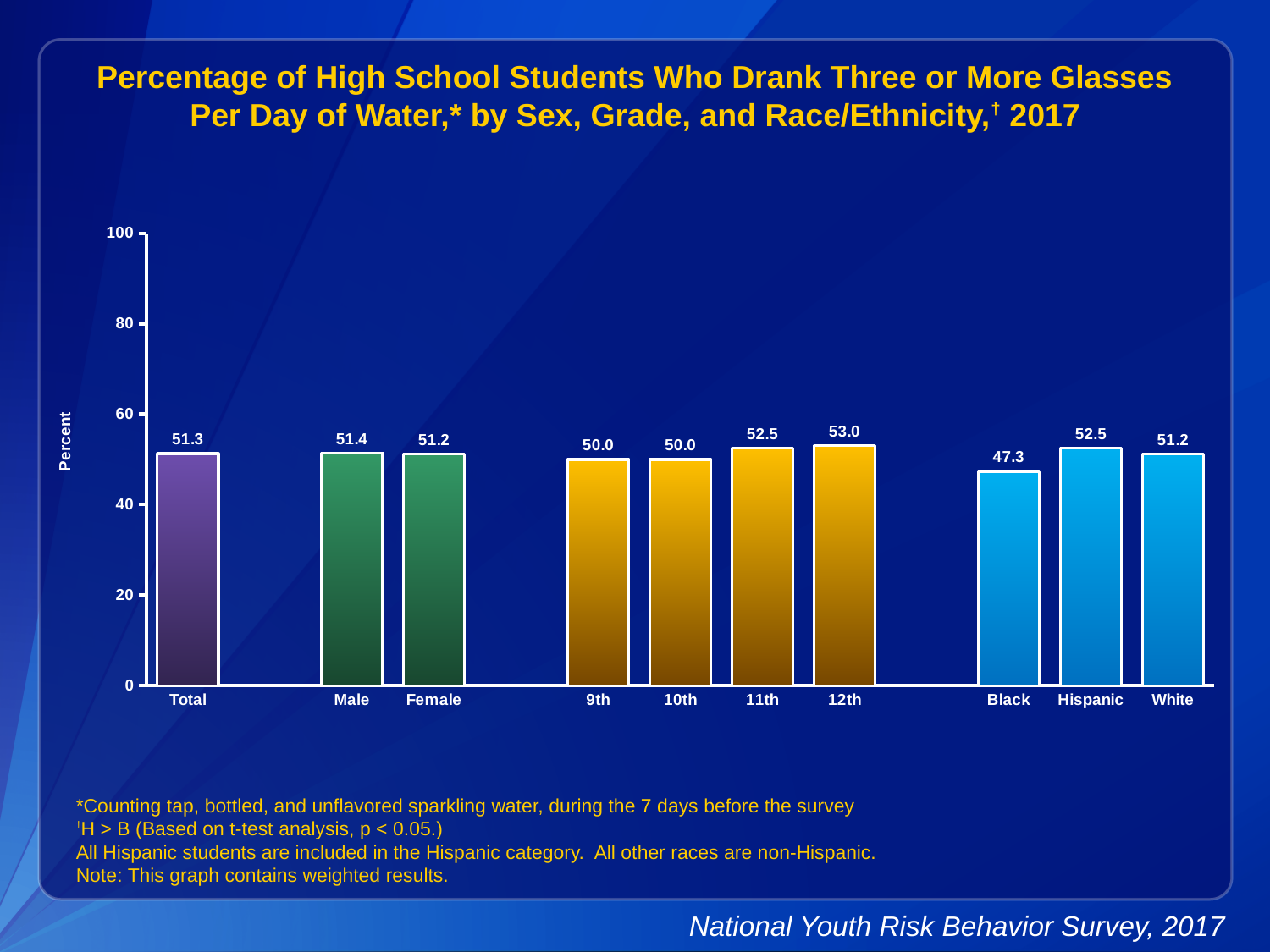
What is the difference between the values for Hispanic and Black students? 5.2 Is the value for White students greater or less than 60? less What is the value for Total? 51.3 How many categories are shown on the x axis? 10 What is the label of the y axis? Percent What is the value for 12th grade? 53.0 Which category has the lowest value? Black Which is larger, the value for 11th grade or the value for 9th grade? 11th What is the difference between the values for Male and Female? 0.2 What kind of chart is shown on the slide? bar chart What is the value for Black students? 47.3 Which category has the highest value? 12th